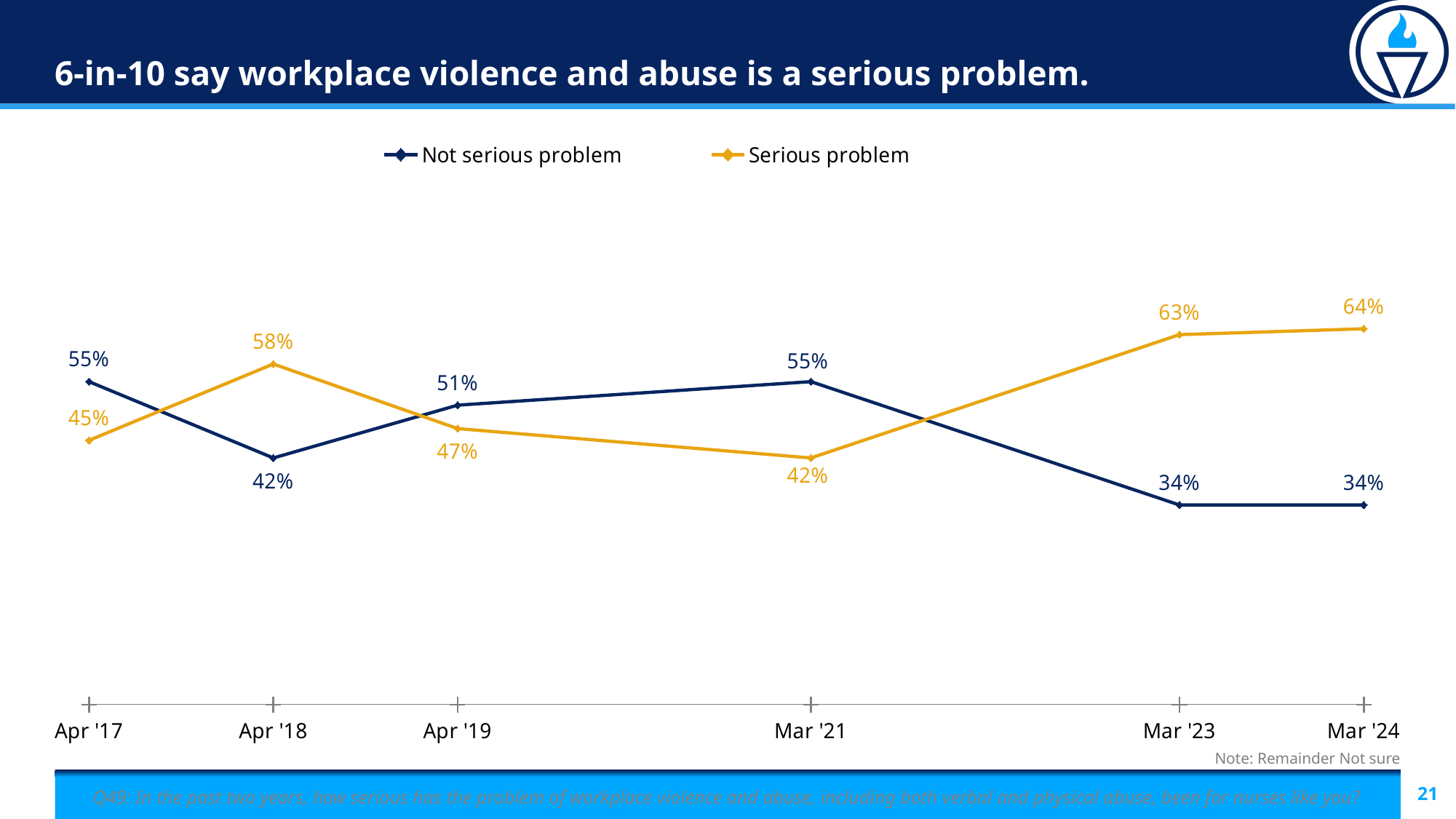
How many time periods are shown on the x axis? 6 In which period is the 'Serious problem' series at its highest? Mar '24 How many series does the legend list? 2 What is the value for 'Serious problem' in Apr '19? 47% What percentage said workplace violence and abuse was a serious problem in Mar '24? 64% What colour is the line for 'Serious problem'? Gold/yellow What kind of chart is shown on the slide? Line chart In which period is the 'Serious problem' series at its lowest? Mar '21 What is the difference between 'Serious problem' and 'Not serious problem' in Mar '24? 30 percentage points What is the value for 'Not serious problem' in Apr '18? 42% In Apr '17, which was larger: 'Serious problem' or 'Not serious problem'? Not serious problem How does the 'Not serious problem' series change from Mar '21 to Mar '23? It falls